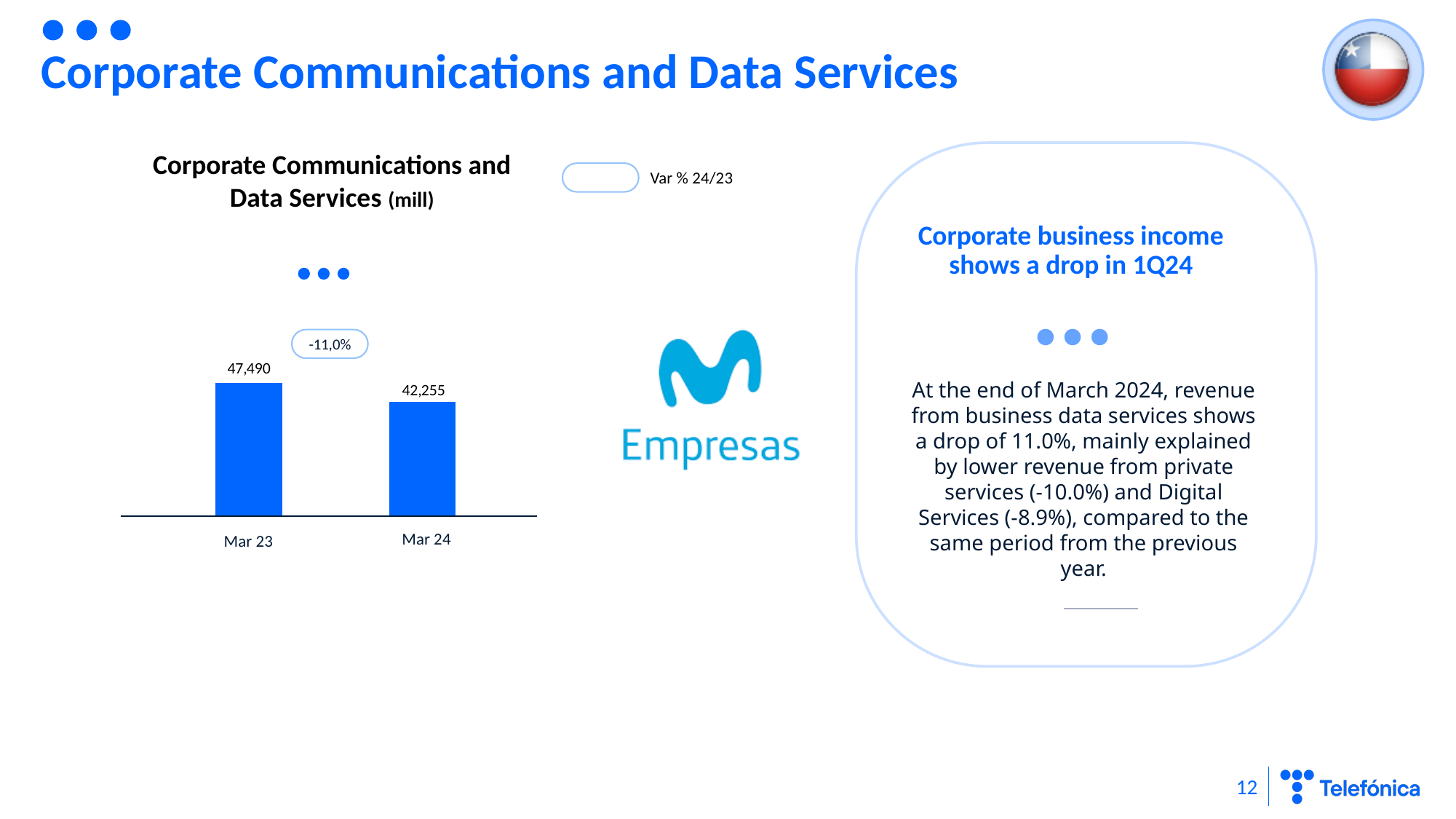
Which period has the higher value? Mar 23 Do the values rise or fall from Mar 23 to Mar 24? fall Which period has the lower value? Mar 24 How many bars are shown in the chart? 2 What is the value for Mar 24? 42,255 What unit is indicated in the chart title? mill What is the difference between the Mar 23 and Mar 24 values? 5,235 What is the value for Mar 23? 47,490 What percentage change (Var % 24/23) is shown above the bars? -11,0% What kind of chart is shown on the slide? bar chart Is the value for Mar 24 larger or smaller than the value for Mar 23? smaller